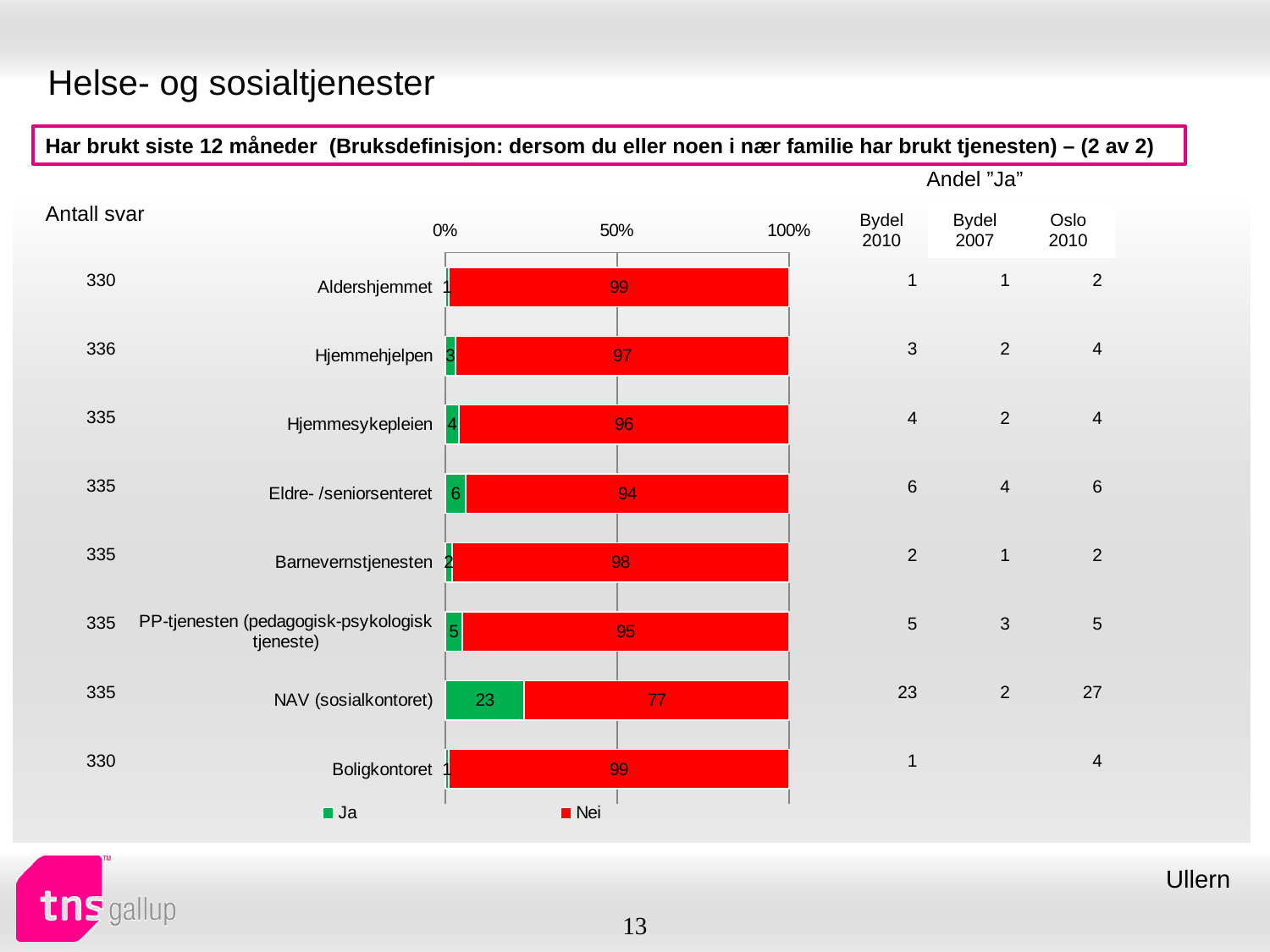
Is the 'Nei' value for Barnevernstjenesten greater or less than 50%? greater Which category has the highest 'Ja' value? NAV (sosialkontoret) What is the difference between the 'Nei' values for Aldershjemmet and NAV (sosialkontoret)? 22 What is the 'Nei' value for Hjemmesykepleien? 96 Which has a larger 'Ja' value, Hjemmehjelpen or PP-tjenesten (pedagogisk-psykologisk tjeneste)? PP-tjenesten (pedagogisk-psykologisk tjeneste) Which category has the lowest 'Nei' value? NAV (sosialkontoret) What is the 'Nei' value for NAV (sosialkontoret)? 77 What is the 'Ja' value for Eldre- /seniorsenteret? 6 What kind of chart is shown on the slide? stacked bar chart How many series does the legend list? 2 What is the total of the stacked bar for NAV (sosialkontoret)? 100 How many categories are shown in the chart? 8